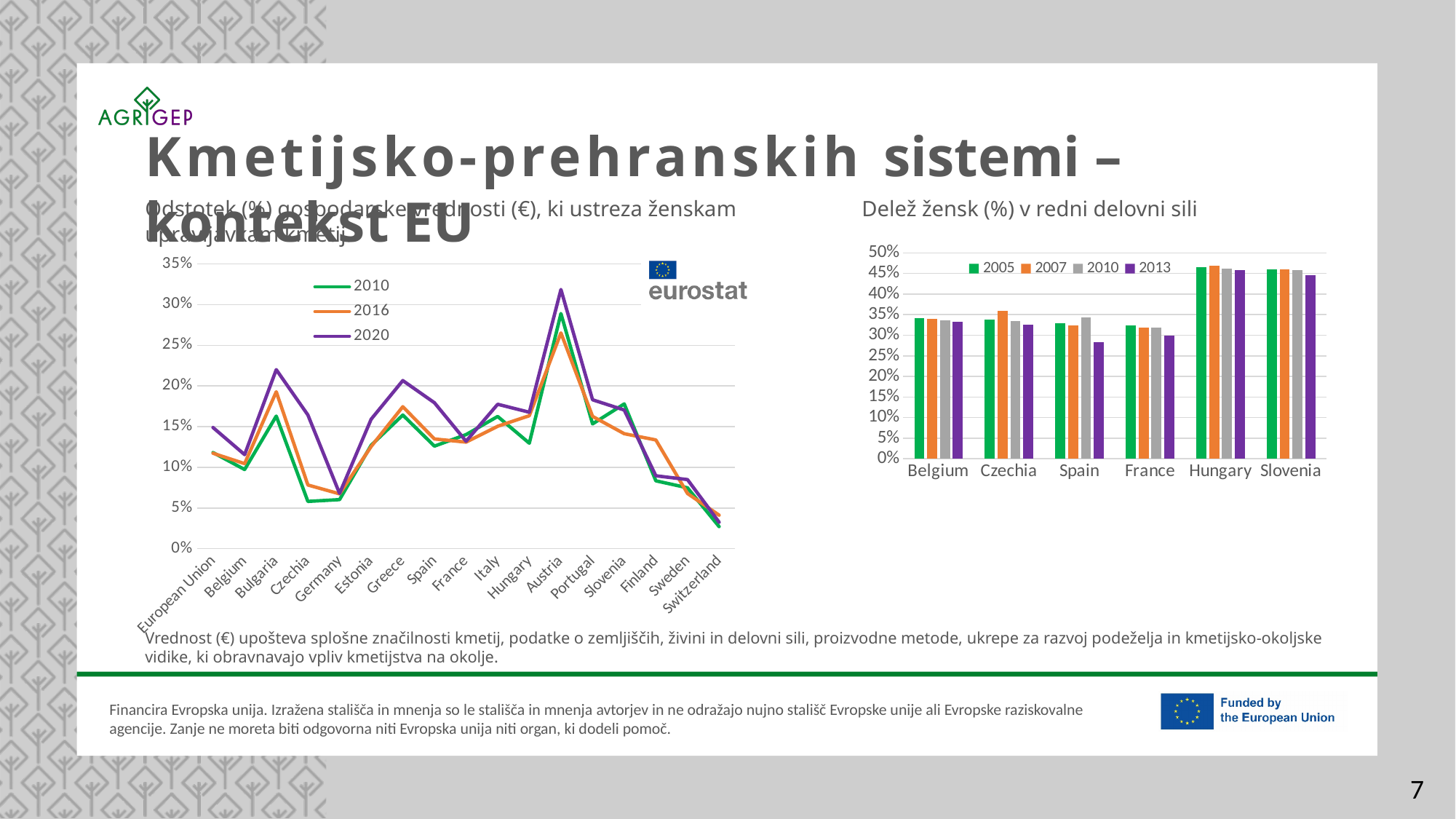
What kind of chart is the chart on the right titled 'Delež žensk (%) v redni delovni sili'? bar chart In the line chart on the left, which category has the highest value for the 2020 series? Austria How many countries are shown on the x axis of the bar chart 'Delež žensk (%) v redni delovni sili'? 6 In the bar chart 'Delež žensk (%) v redni delovni sili', which is larger for Spain: the 2010 value or the 2013 value? 2010 In the bar chart 'Delež žensk (%) v redni delovni sili', is the 2005 value for Hungary greater or less than 40%? greater In the line chart on the left, is the 2020 value for Austria greater or less than 30%? greater How many categories are shown on the x axis of the line chart on the left? 17 In the line chart on the left, is the 2010 value for Czechia greater or less than 10%? less What kind of chart is the chart on the left of the slide? line chart How many series does the legend of the line chart on the left list? 3 How many series does the legend of the bar chart 'Delež žensk (%) v redni delovni sili' list? 4 In the line chart on the left, which category has the lowest value for the 2010 series? Switzerland